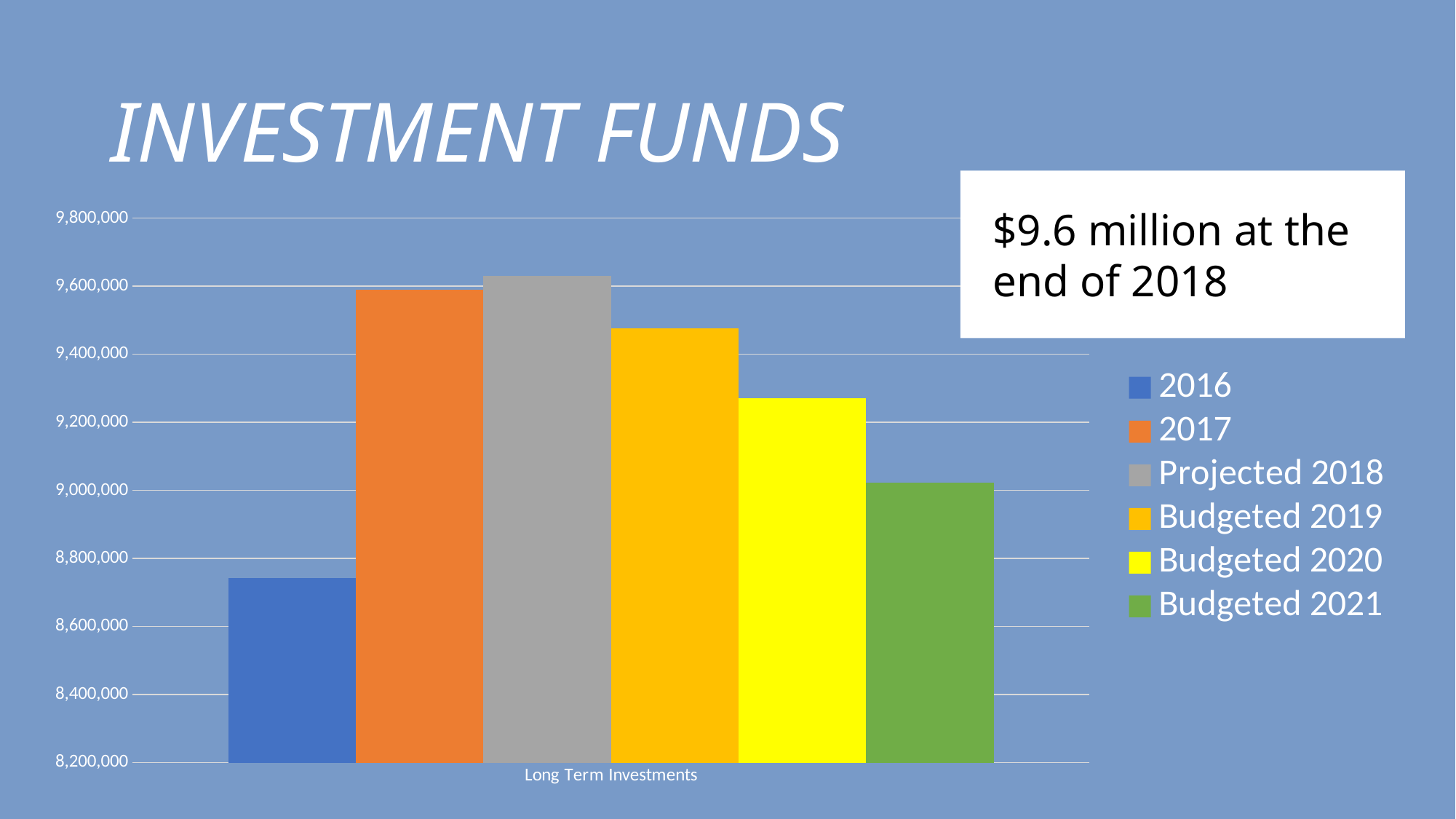
Which series has the lowest value for Long Term Investments? 2016 Is the value for 2017 greater or less than 9,400,000? greater How many categories are shown on the x axis? 1 Is the value for Budgeted 2021 greater or less than 9,200,000? less Which is larger, the value for 2017 or the value for 2016? 2017 Is the value for 2016 greater or less than 8,800,000? less Which is larger, the value for Budgeted 2019 or the value for Budgeted 2020? Budgeted 2019 What is the title of the slide containing the chart? INVESTMENT FUNDS What colour is the bar for Budgeted 2020? yellow How many series does the legend list? 6 What kind of chart is shown on the slide? bar chart